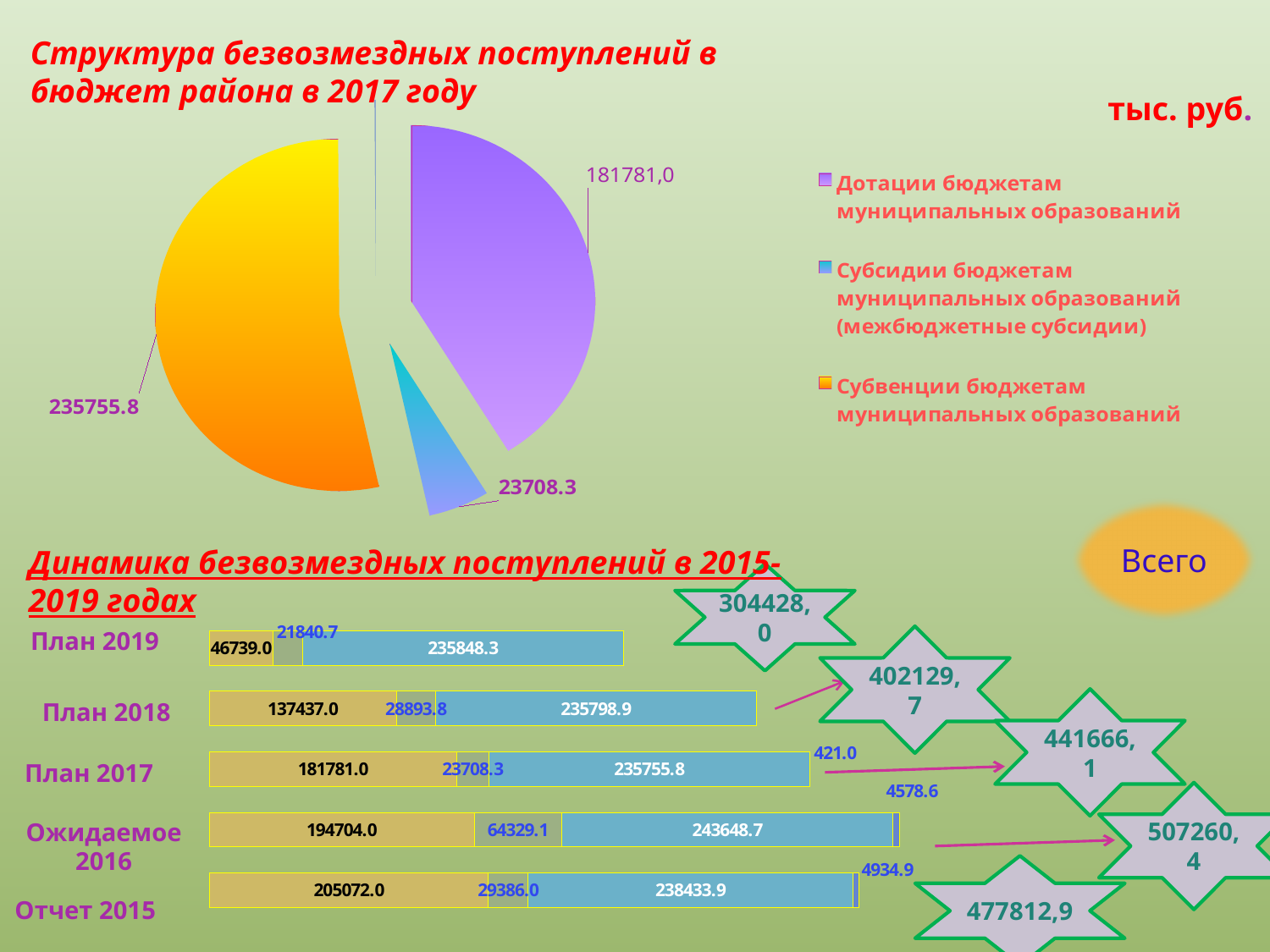
In the pie chart 'Структура безвозмездных поступлений в бюджет района в 2017 году', what is the value for Субвенции бюджетам муниципальных образований? 235755.8 What kind of chart is 'Динамика безвозмездных поступлений в 2015-2019 годах'? Stacked bar chart In the chart 'Динамика безвозмездных поступлений в 2015-2019 годах', what is the value of the largest segment for Ожидаемое 2016? 243648.7 In the chart 'Динамика безвозмездных поступлений в 2015-2019 годах', what is the total (Всего) for План 2019? 304428,0 In the chart 'Динамика безвозмездных поступлений в 2015-2019 годах', what is the difference between the first segment of Отчет 2015 (205072.0) and the first segment of План 2019 (46739.0)? 158333.0 In the pie chart 'Структура безвозмездных поступлений в бюджет района в 2017 году', what colour is the slice for Субвенции бюджетам муниципальных образований? Orange/yellow In the pie chart 'Структура безвозмездных поступлений в бюджет района в 2017 году', what is the value for Дотации бюджетам муниципальных образований? 181781,0 In the chart 'Динамика безвозмездных поступлений в 2015-2019 годах', which year has the highest total (Всего)? Ожидаемое 2016 In the chart 'Динамика безвозмездных поступлений в 2015-2019 годах', what is the total (Всего) for Отчет 2015? 477812,9 In the chart 'Динамика безвозмездных поступлений в 2015-2019 годах', what is the value of the first (leftmost) segment for План 2018? 137437.0